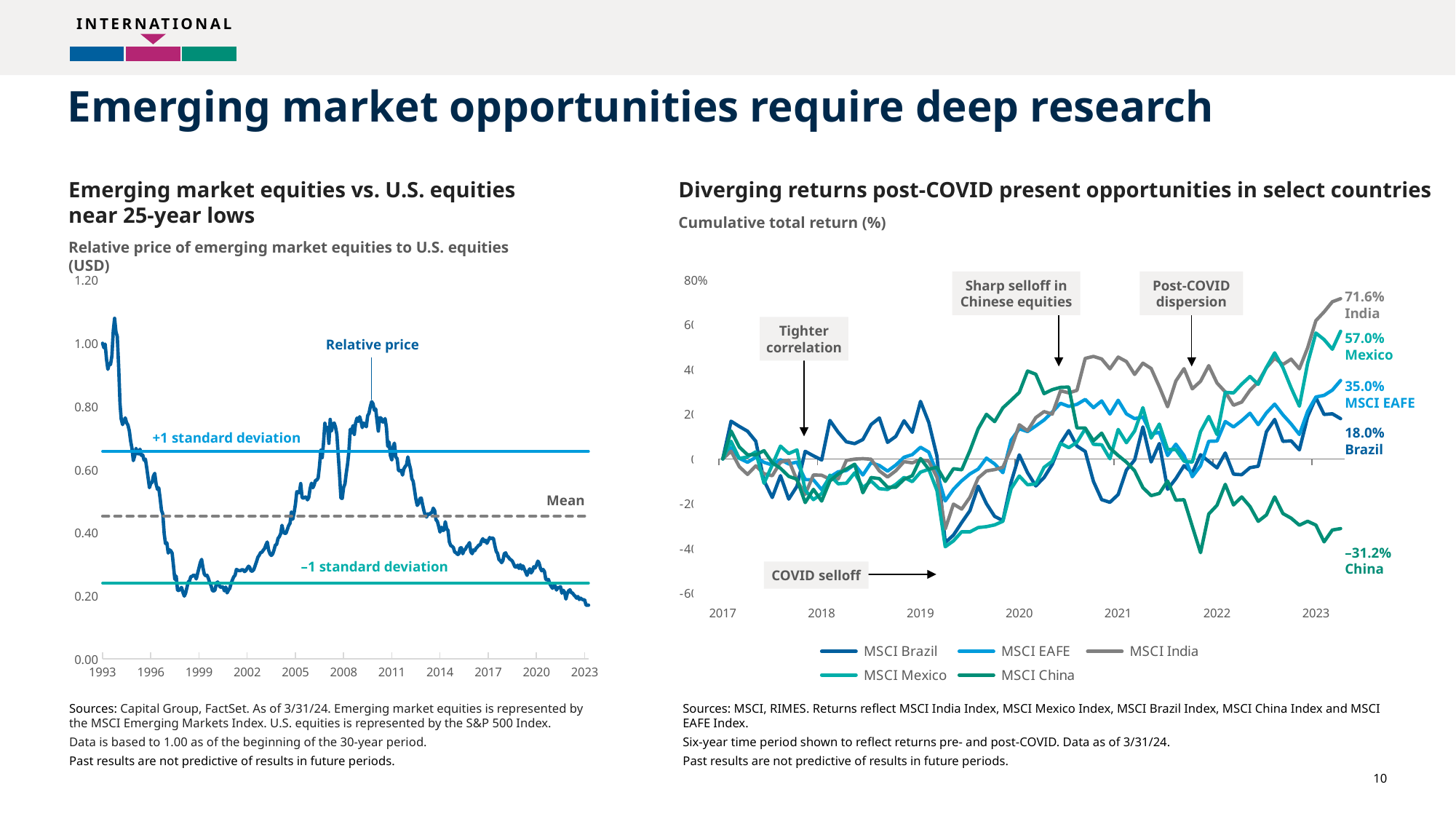
What kind of chart is the right chart (Diverging returns post-COVID)? Line chart In the left chart (Emerging market equities vs. U.S. equities), does the relative price generally rise or fall from 2011 to 2023? fall In the right chart (Diverging returns post-COVID), which has the higher end-of-period return, MSCI Mexico or MSCI EAFE? MSCI Mexico In the right chart (Diverging returns post-COVID), what is the cumulative total return shown for MSCI China at the end of the period? –31.2% In the right chart (Diverging returns post-COVID), which index has the highest cumulative total return at the end of the period? MSCI India In the right chart (Diverging returns post-COVID), which index has the lowest cumulative total return at the end of the period? MSCI China In the left chart (Emerging market equities vs. U.S. equities), is the relative price at the end of 2023 greater or less than 0.40? less In the right chart (Diverging returns post-COVID), what is the cumulative total return shown for MSCI Brazil at the end of the period? 18.0% In the left chart (Emerging market equities vs. U.S. equities), what does the dashed grey horizontal line represent? Mean In the right chart (Diverging returns post-COVID), how many series does the legend list? 5 In the right chart (Diverging returns post-COVID), what is the cumulative total return shown for MSCI India at the end of the period? 71.6% In the right chart (Diverging returns post-COVID), what is the difference between the end-of-period returns of MSCI India and MSCI Mexico? 14.6 percentage points